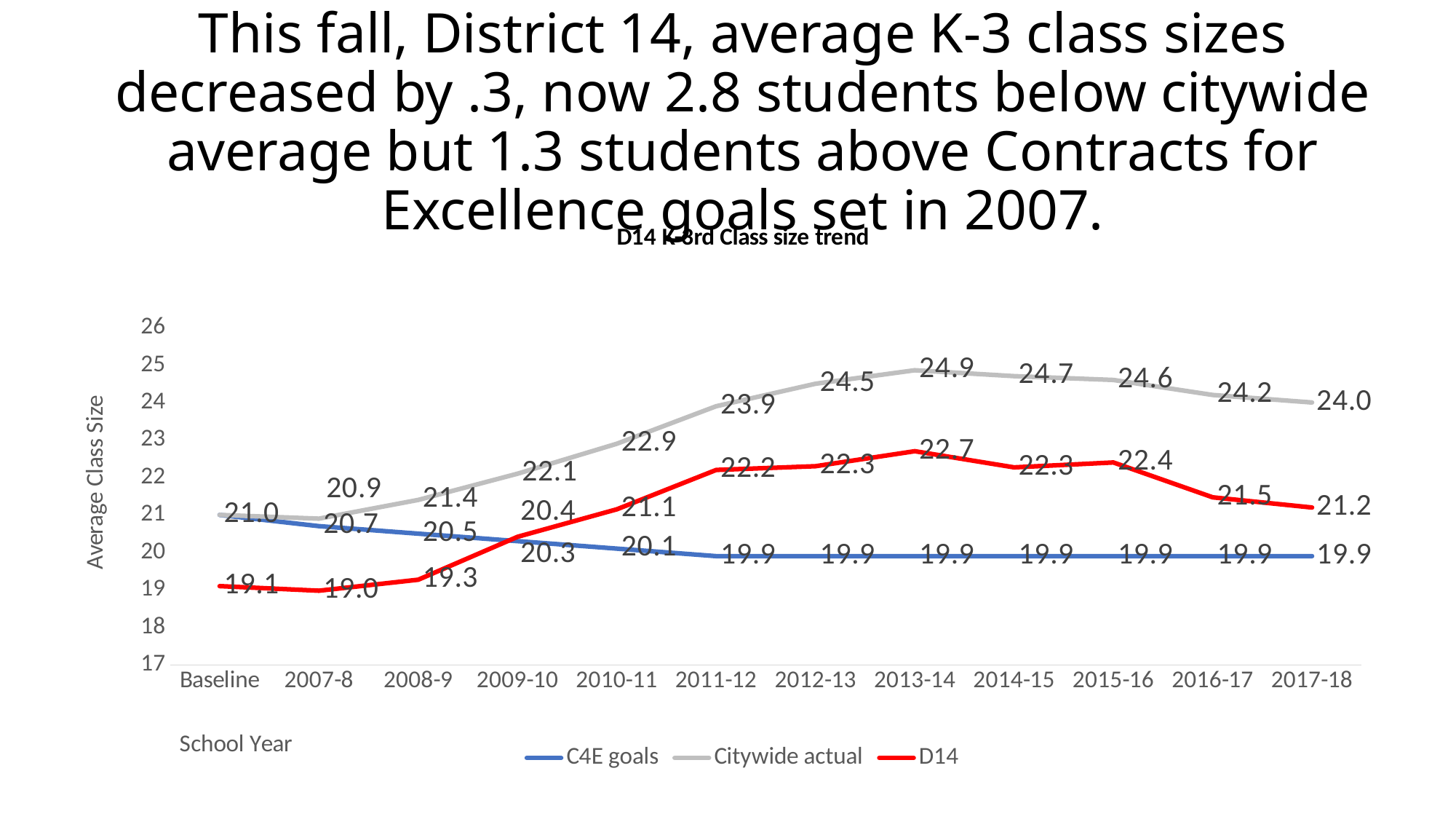
In which school year is the Citywide actual value highest? 2013-14 In which school year is the D14 value lowest? 2007-8 What is the difference between the Citywide actual and D14 values in 2017-18? 2.8 How many school-year points are plotted along the x axis? 12 What is the D14 value for 2017-18? 21.2 In 2011-12, which is larger: the D14 value or the C4E goals value? D14 What colour is the D14 line? red What kind of chart is shown on the slide? line chart How many series does the legend list? 3 What is the Citywide actual value for 2013-14? 24.9 What is the difference between the D14 and C4E goals values in 2017-18? 1.3 Does the Citywide actual series rise or fall from 2008-9 to 2013-14? rise